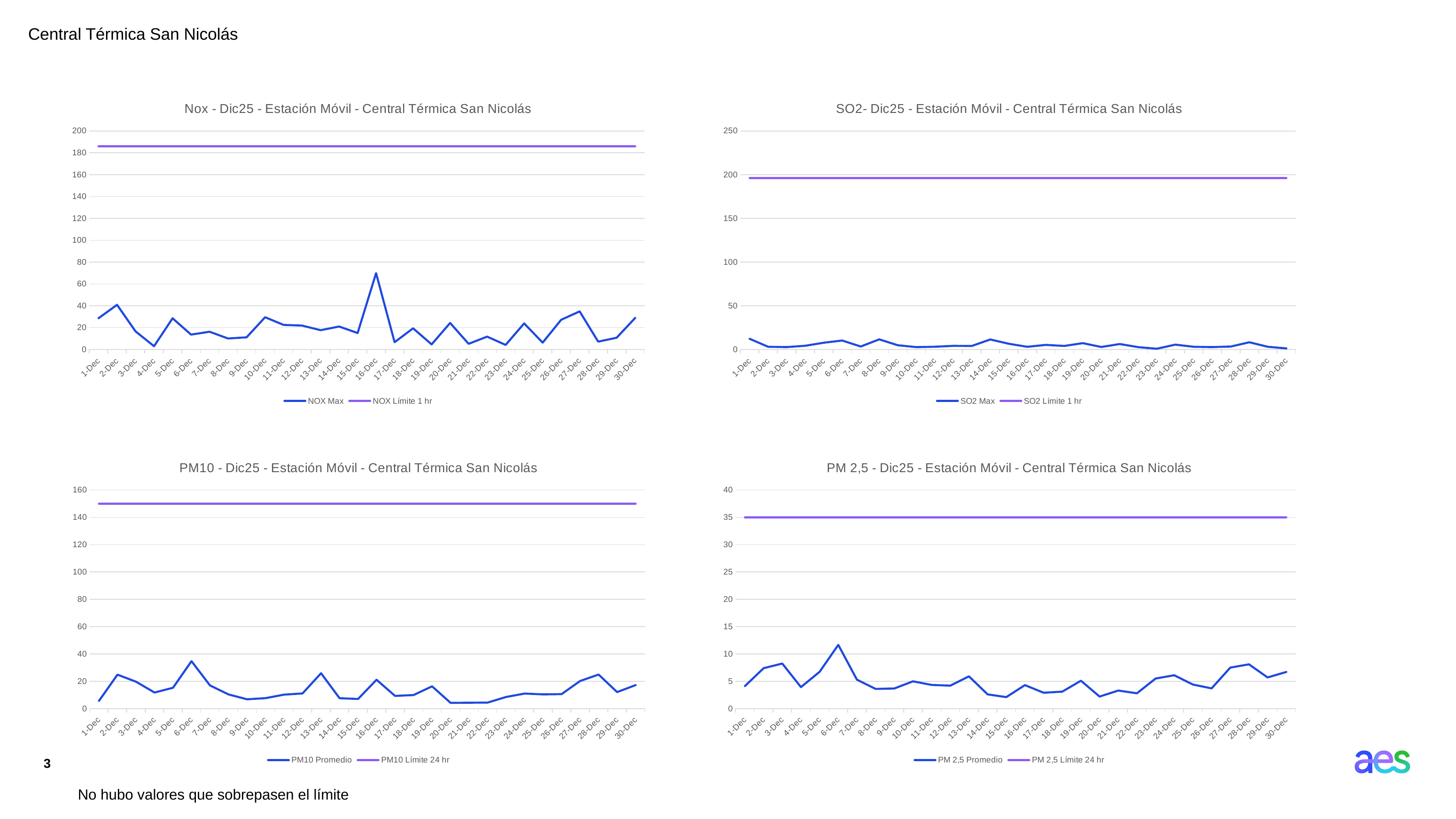
In the 'Nox - Dic25 - Estación Móvil - Central Térmica San Nicolás' chart, is the NOX Límite 1 hr line greater or less than 180? greater In the 'PM10 - Dic25 - Estación Móvil - Central Térmica San Nicolás' chart, on which date does PM10 Promedio reach its highest value? 6-Dec In the 'Nox - Dic25 - Estación Móvil - Central Térmica San Nicolás' chart, is the NOX Max value on 16-Dec greater or less than 60? greater What kind of chart is the 'Nox - Dic25 - Estación Móvil - Central Térmica San Nicolás' chart? line chart How many series does the legend of the 'SO2- Dic25 - Estación Móvil - Central Térmica San Nicolás' chart list? 2 In the 'PM 2,5 - Dic25 - Estación Móvil - Central Térmica San Nicolás' chart, on which date does PM 2,5 Promedio reach its highest value? 6-Dec In the 'Nox - Dic25 - Estación Móvil - Central Térmica San Nicolás' chart, on which date does NOX Max reach its highest value? 16-Dec What are the two legend entries of the 'PM 2,5 - Dic25 - Estación Móvil - Central Térmica San Nicolás' chart? PM 2,5 Promedio and PM 2,5 Límite 24 hr In the 'PM10 - Dic25 - Estación Móvil - Central Térmica San Nicolás' chart, is the PM10 Límite 24 hr line greater or less than 140? greater In the 'PM 2,5 - Dic25 - Estación Móvil - Central Térmica San Nicolás' chart, what value does the PM 2,5 Límite 24 hr line sit at? 35 How many dates are plotted along the x axis of the 'PM10 - Dic25 - Estación Móvil - Central Térmica San Nicolás' chart? 30